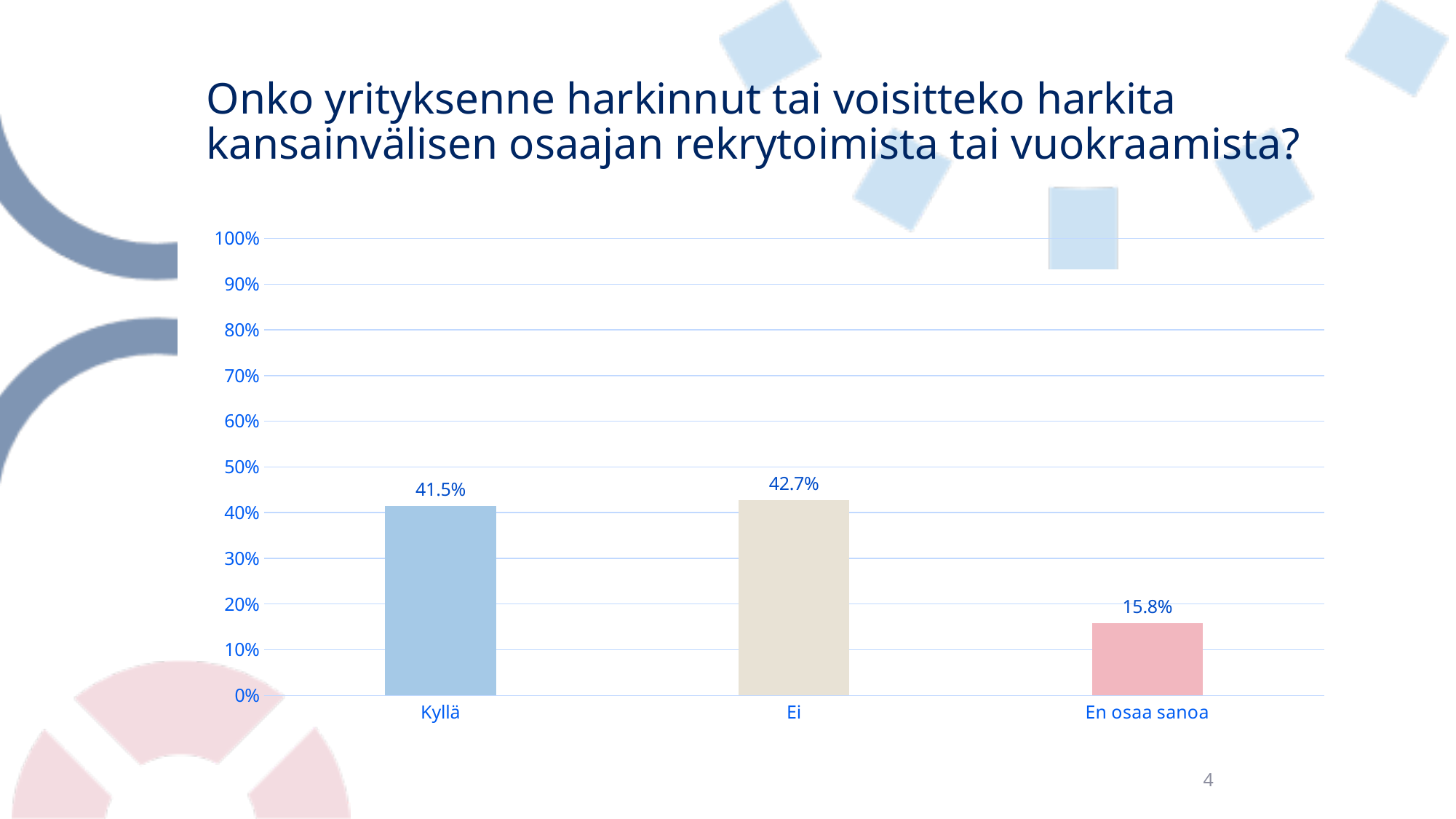
Which is larger, the value for Kyllä or the value for En osaa sanoa? Kyllä Which category has the lowest value? En osaa sanoa Is the value for En osaa sanoa greater or less than 10%? greater What is the difference between the values for Ei and Kyllä? 1.2% Is the value for Ei greater or less than 50%? less What is the difference between the values for Kyllä and En osaa sanoa? 25.7% What kind of chart is shown on the slide? bar chart How many categories are shown on the x axis? 3 What is the value for Kyllä? 41.5% What is the highest value shown on the y axis? 100% What is the value for En osaa sanoa? 15.8% What is the value for Ei? 42.7%